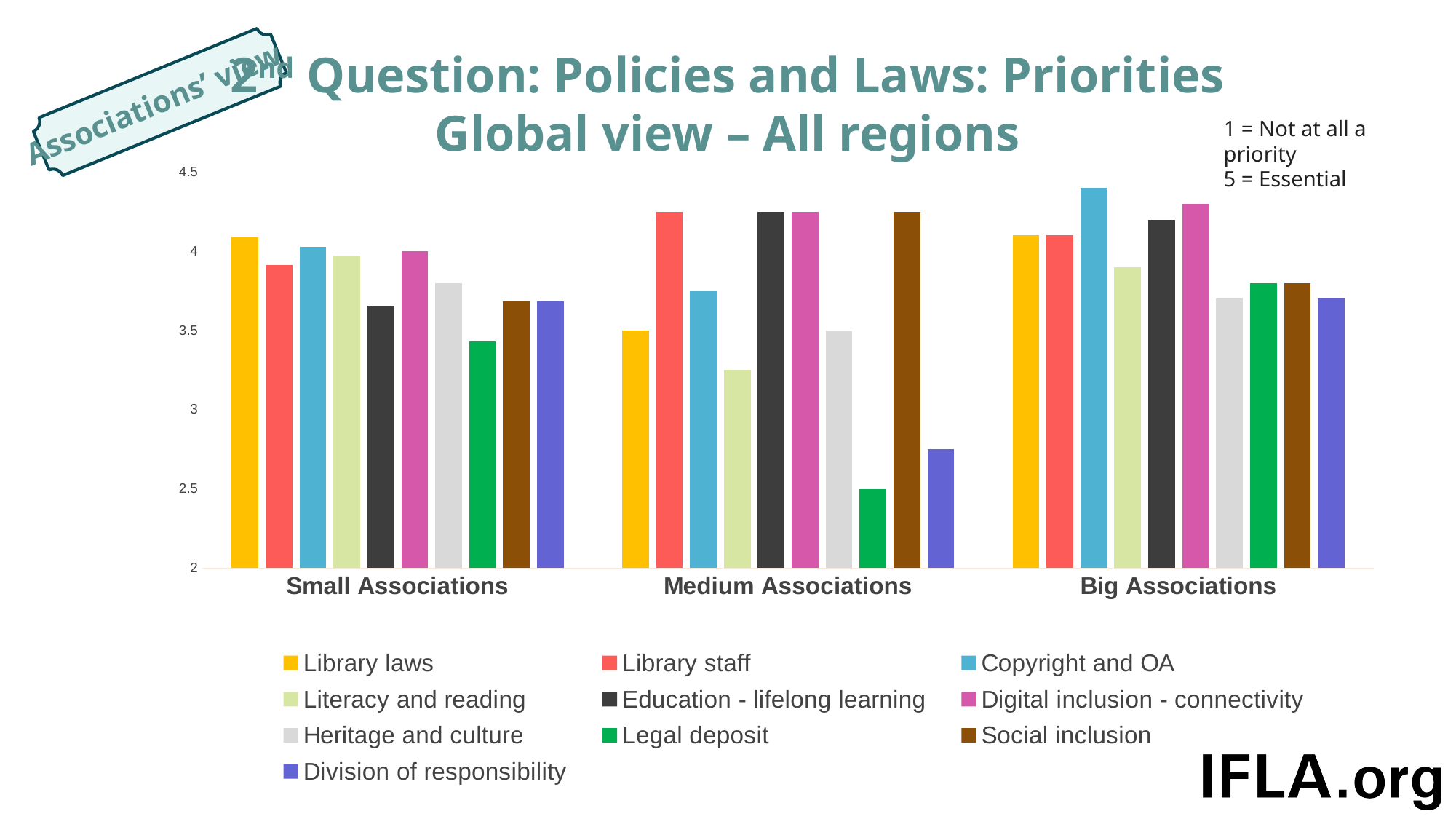
According to the note on the slide, what does a score of 5 mean? Essential Which priority has the lowest value for Medium Associations? Legal deposit Which priority has the lowest value for Small Associations? Legal deposit For Medium Associations, which is larger: Library laws or Library staff? Library staff Is the value for Library staff among Medium Associations greater or less than 4? greater Is the value for Legal deposit among Medium Associations greater or less than 3? less For Legal deposit, which group has the larger value: Small Associations or Medium Associations? Small Associations Is the value for Division of responsibility among Medium Associations greater or less than 3? less How many association size categories are shown on the x axis? 3 Which priority has the highest value for Big Associations? Copyright and OA What kind of chart is shown on the slide? Bar chart How many series does the legend list? 10